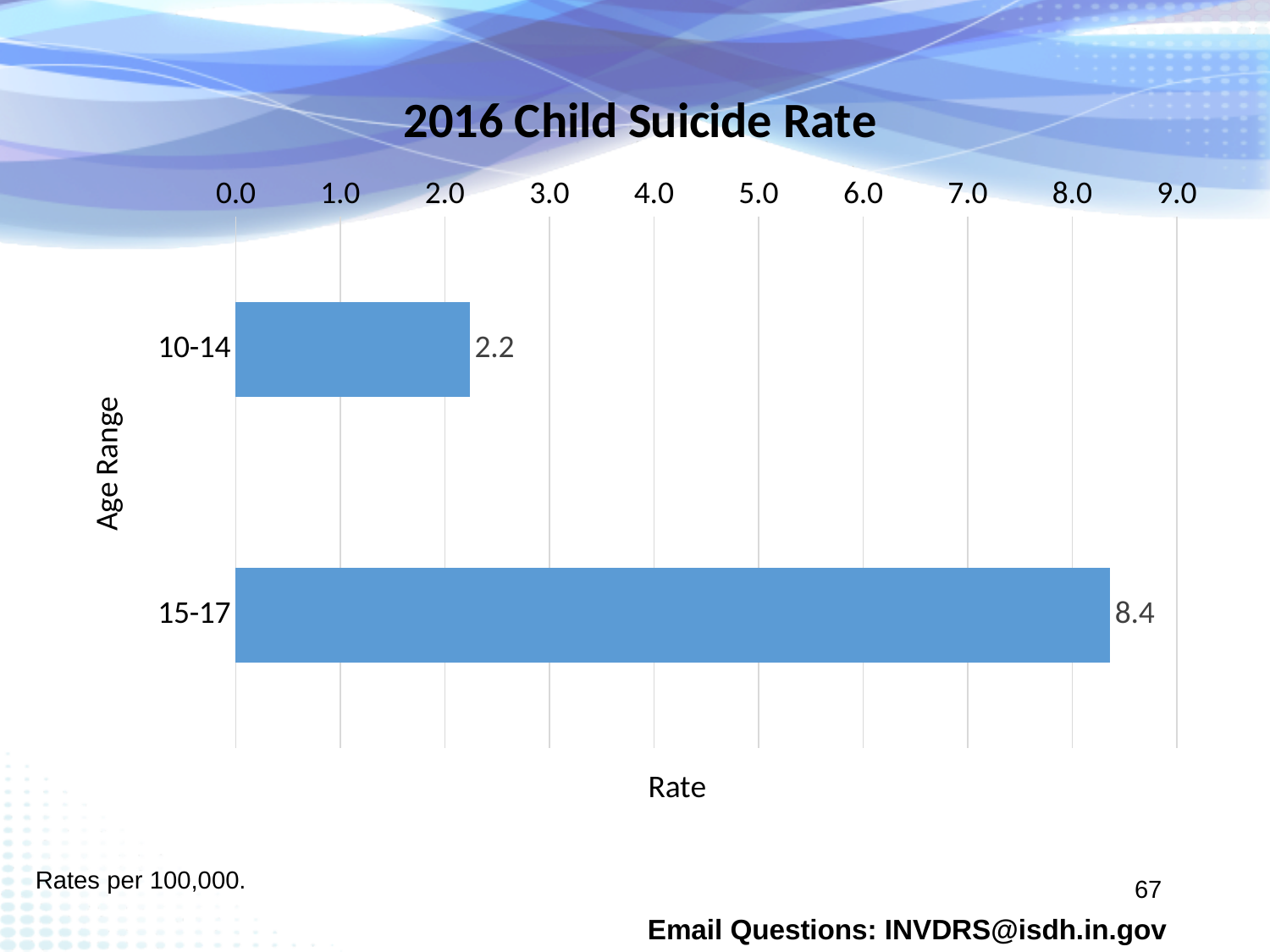
Which age range has a larger suicide rate, 10-14 or 15-17? 15-17 What is the suicide rate for the 15-17 age range? 8.4 Which age range has the lowest suicide rate? 10-14 What is the label of the vertical axis? Age Range What is the suicide rate for the 10-14 age range? 2.2 What is the title of the chart? 2016 Child Suicide Rate What kind of chart is shown on the slide? Bar chart Which age range has the highest suicide rate? 15-17 What is the difference between the suicide rates for the 15-17 and 10-14 age ranges? 6.2 How many age ranges are shown in the chart? 2 Is the value for the 10-14 age range greater or less than 3.0? less Is the value for the 15-17 age range greater or less than 8.0? greater